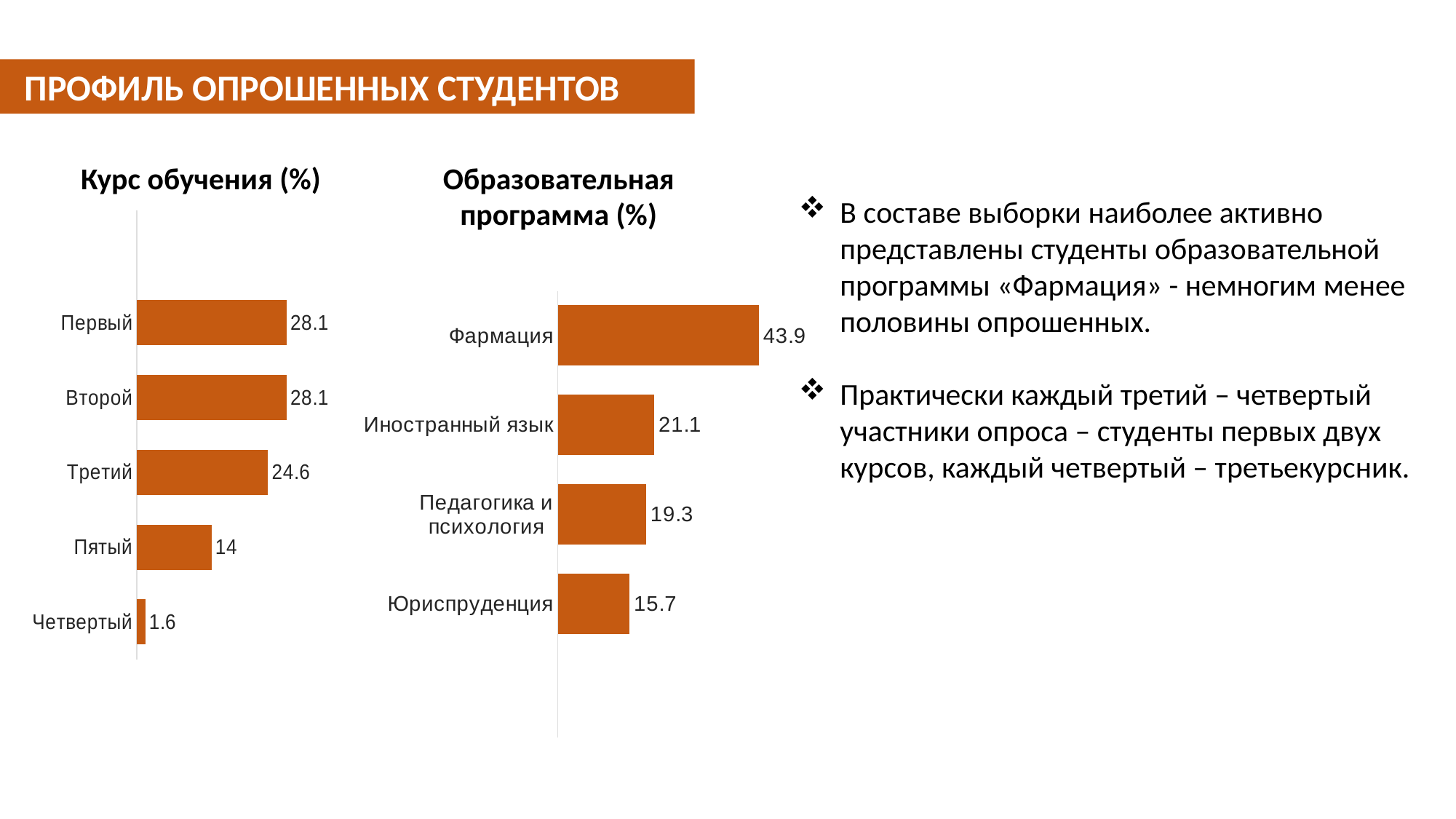
In the chart titled "Курс обучения (%)", what is the difference between the values for Третий and Пятый? 10.6 In the chart titled "Образовательная программа (%)", what is the value for Педагогика и психология? 19.3 In the chart titled "Образовательная программа (%)", which category has the highest value? Фармация In the chart titled "Образовательная программа (%)", what is the value for Фармация? 43.9 In the chart titled "Курс обучения (%)", which is larger, the value for Пятый or the value for Четвертый? Пятый In the chart titled "Образовательная программа (%)", which category has the lowest value? Юриспруденция What type of chart is the chart titled "Образовательная программа (%)"? Bar chart How many categories are shown in the chart titled "Курс обучения (%)"? 5 In the chart titled "Курс обучения (%)", what is the value for Четвертый? 1.6 In the chart titled "Образовательная программа (%)", what is the difference between the values for Фармация and Иностранный язык? 22.8 In the chart titled "Курс обучения (%)", which category has the lowest value? Четвертый In the chart titled "Курс обучения (%)", what is the value for Третий? 24.6